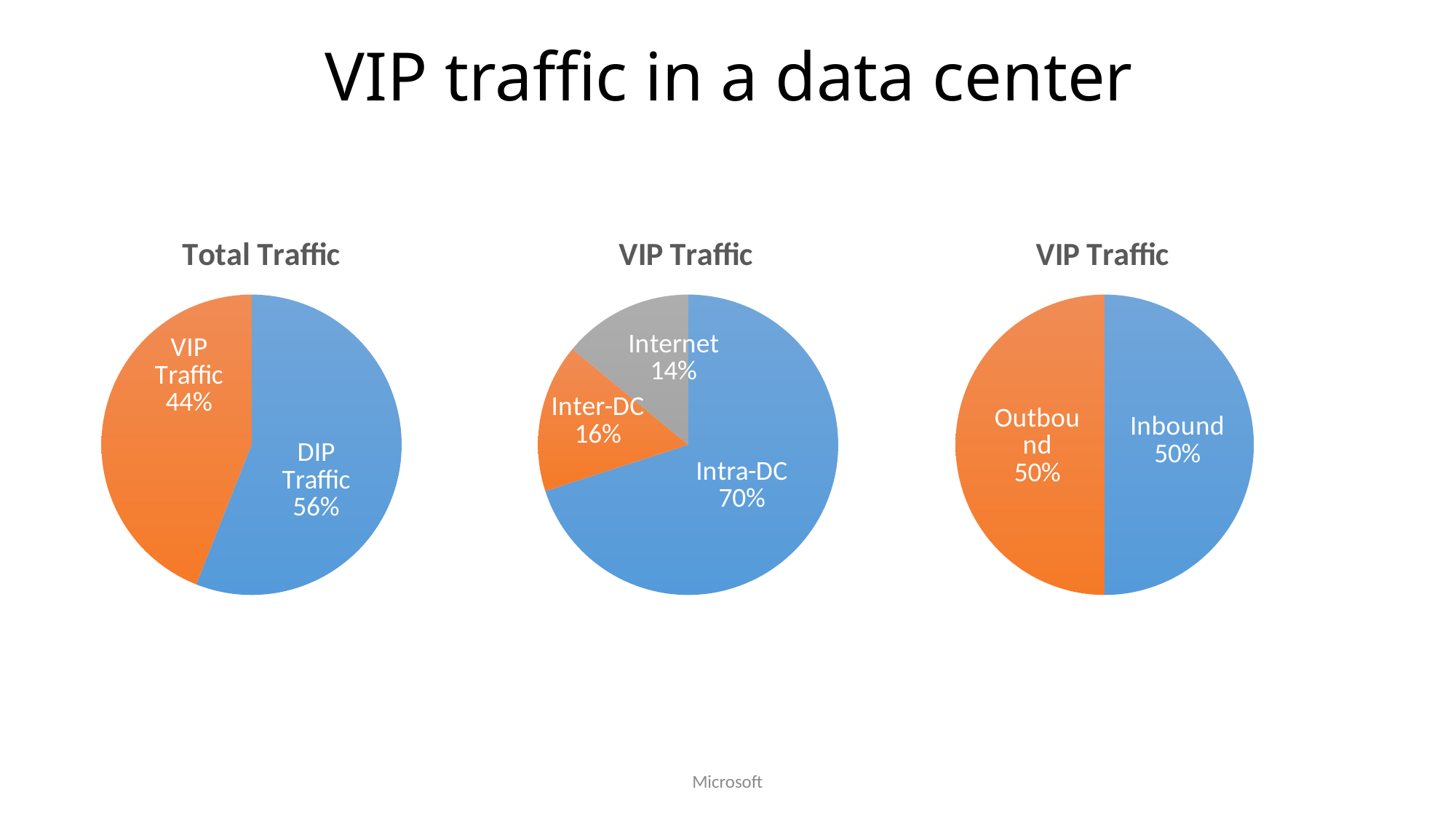
In the 'Total Traffic' pie chart on the left, what is the difference between the DIP Traffic and VIP Traffic shares? 12% In the 'Total Traffic' pie chart on the left, which slice is larger, VIP Traffic or DIP Traffic? DIP Traffic In the 'Total Traffic' pie chart on the left, what share is DIP Traffic? 56% In the middle 'VIP Traffic' pie chart, which category has the smallest share? Internet In the middle 'VIP Traffic' pie chart, what share is Inter-DC? 16% In the rightmost 'VIP Traffic' pie chart, what share is Inbound? 50% In the 'Total Traffic' pie chart on the left, what share is VIP Traffic? 44% In the middle 'VIP Traffic' pie chart, what share is Internet? 14% In the middle 'VIP Traffic' pie chart, which category has the largest share? Intra-DC How many slices does the middle 'VIP Traffic' pie chart have? 3 What type of chart is the 'Total Traffic' chart on the left? Pie chart In the middle 'VIP Traffic' pie chart, what share is Intra-DC? 70%